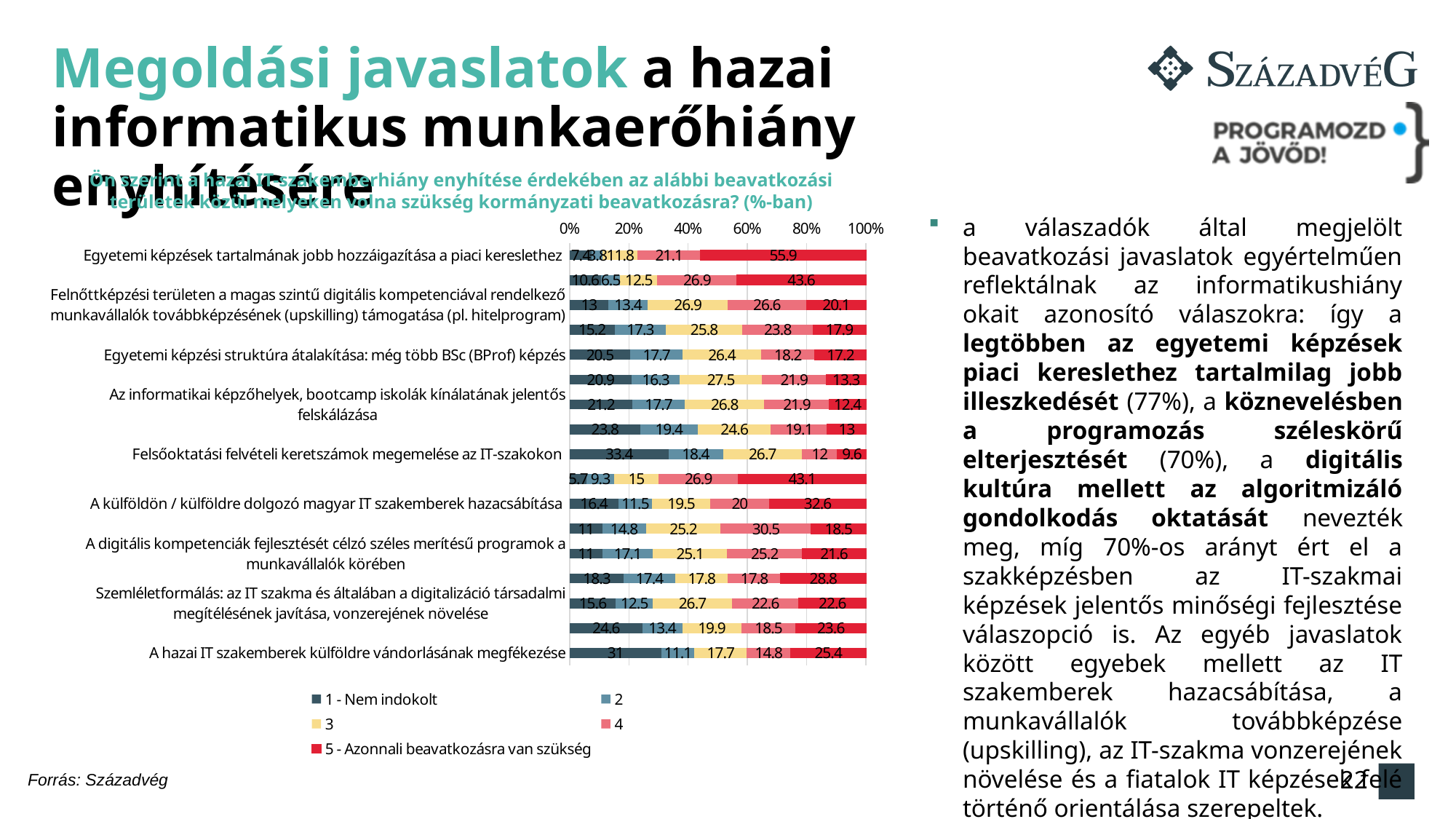
What is the value of series '4' for 'A hazai IT szakemberek külföldre vándorlásának megfékezése'? 14.8 What is the first entry listed in the chart legend? 1 - Nem indokolt What is the value of '5 - Azonnali beavatkozásra van szükség' for 'A külföldön / külföldre dolgozó magyar IT szakemberek hazacsábítása'? 32.6 How many series does the legend list? 5 What type of chart is shown on the slide? Stacked bar chart Which category has the highest value for '5 - Azonnali beavatkozásra van szükség'? Egyetemi képzések tartalmának jobb hozzáigazítása a piaci kereslethez What is the value of '1 - Nem indokolt' for 'Felsőoktatási felvételi keretszámok megemelése az IT-szakokon'? 33.4 Which has the larger '1 - Nem indokolt' value: 'Felsőoktatási felvételi keretszámok megemelése az IT-szakokon' or 'A hazai IT szakemberek külföldre vándorlásának megfékezése'? Felsőoktatási felvételi keretszámok megemelése az IT-szakokon What is the difference in the '5 - Azonnali beavatkozásra van szükség' value between 'Egyetemi képzések tartalmának jobb hozzáigazítása a piaci kereslethez' and 'A külföldön / külföldre dolgozó magyar IT szakemberek hazacsábítása'? 23.3 What is the value of '5 - Azonnali beavatkozásra van szükség' for 'Egyetemi képzések tartalmának jobb hozzáigazítása a piaci kereslethez'? 55.9 What is the value of '1 - Nem indokolt' for 'A hazai IT szakemberek külföldre vándorlásának megfékezése'? 31 What is the value of series '3' for 'Egyetemi képzési struktúra átalakítása: még több BSc (BProf) képzés'? 26.4